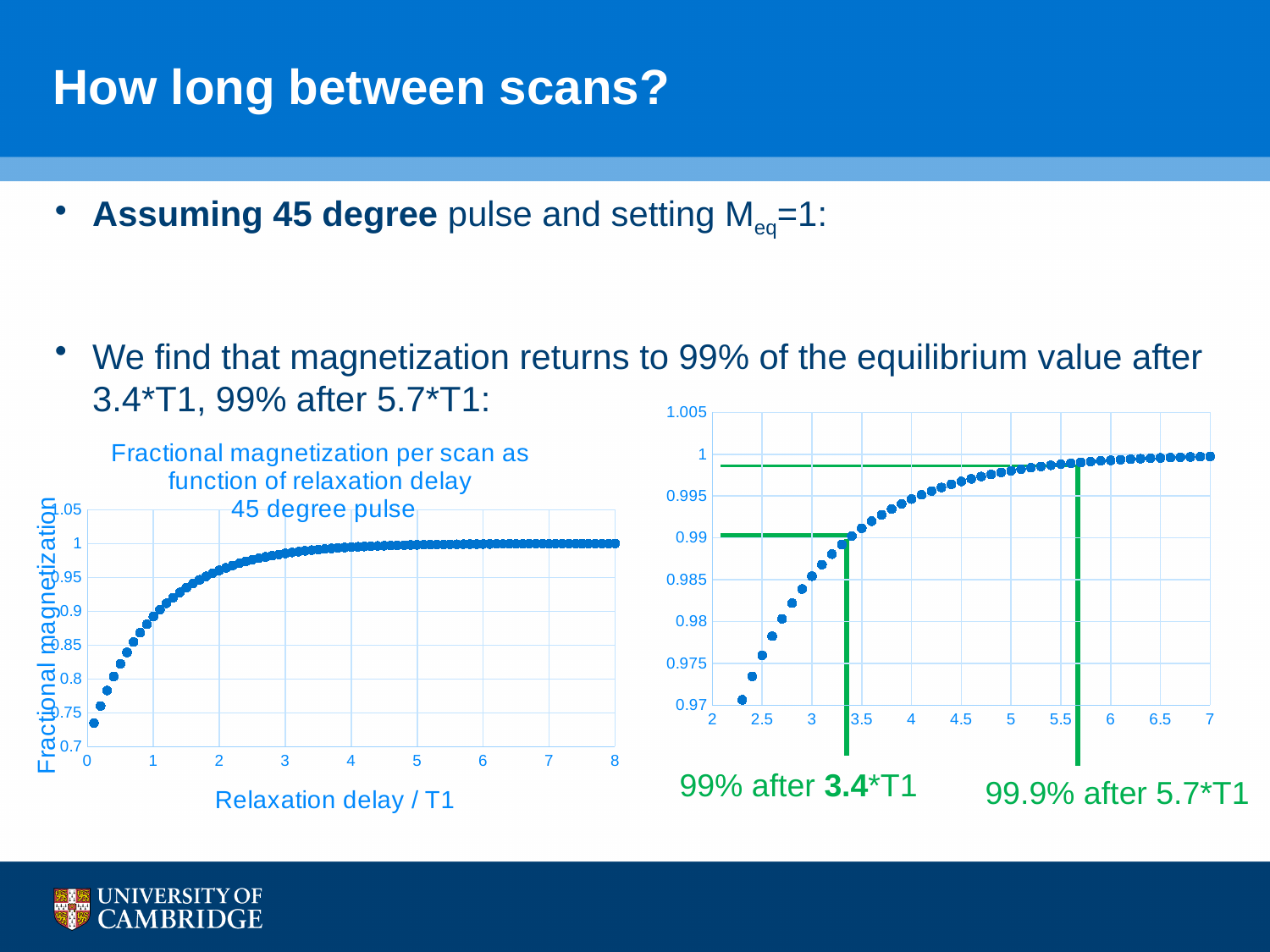
In the right chart, is the value at x = 2.5 greater or less than 0.98? less According to the annotation on the right chart, after how many T1 does the magnetization reach 99%? 3.4*T1 In the right chart, is the value at x = 5 greater or less than 0.995? greater What is the x-axis title of the left chart? Relaxation delay / T1 In the right chart (x axis from 2 to 7), do the plotted values rise or fall as x increases? rise What is the y-axis title of the left chart? Fractional magnetization In the left chart, do the plotted values rise or fall as the relaxation delay increases from 0 to 8? rise What kind of chart is the left chart titled 'Fractional magnetization per scan as function of relaxation delay 45 degree pulse'? scatter chart In the left chart, is the value at relaxation delay 2 greater or less than 0.95? greater According to the annotation on the right chart, after how many T1 does the magnetization reach 99.9%? 5.7*T1